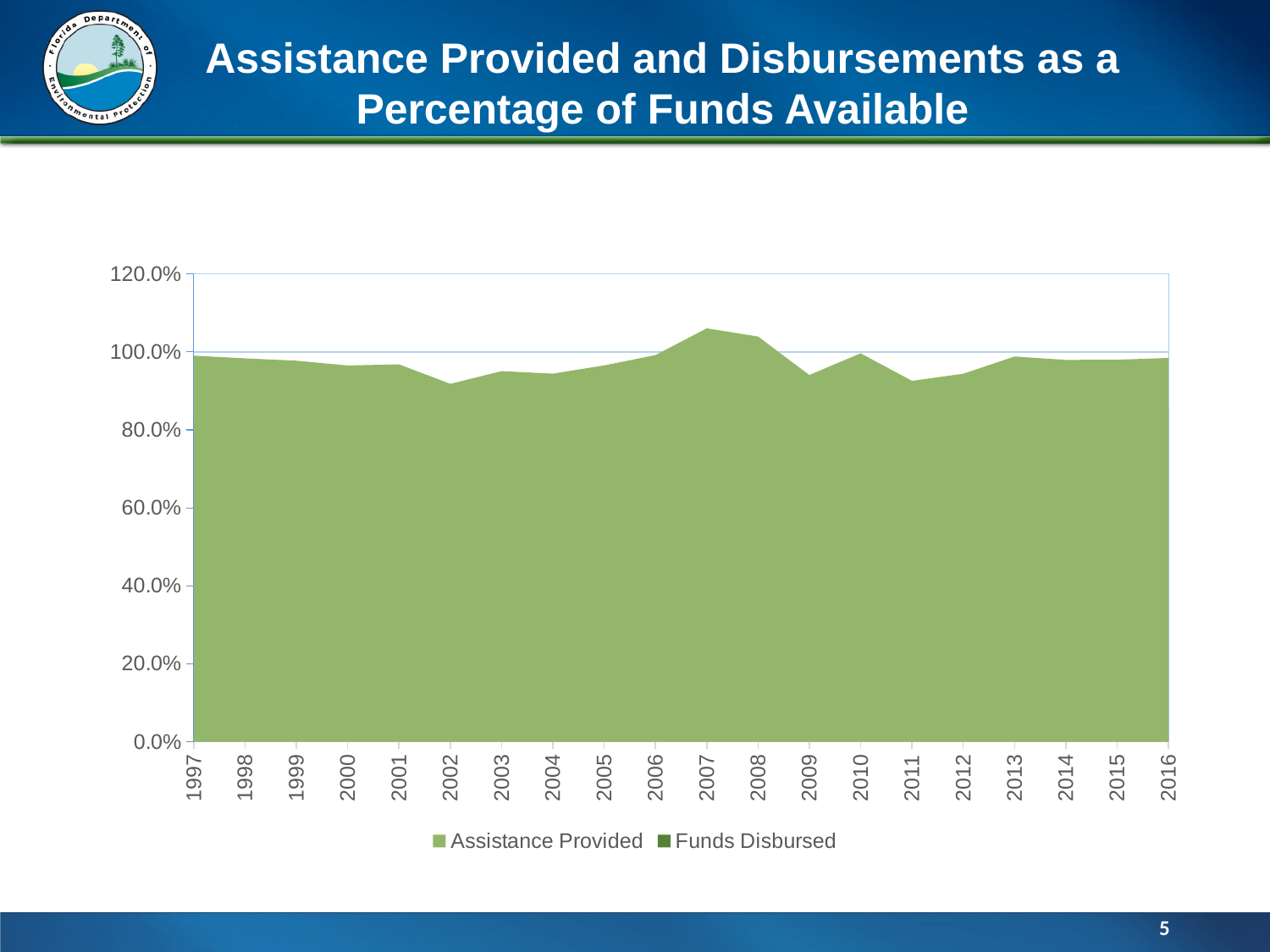
What kind of chart is shown on the slide? Area chart Which year has the highest value for Assistance Provided? 2007 Does the Assistance Provided value rise or fall from 2002 to 2007? rise Is the value for Assistance Provided in 2007 greater or less than 100.0%? greater Which is larger, the Assistance Provided value for 2007 or for 2009? 2007 Is the value for Assistance Provided in 2009 greater or less than 100.0%? less How many series does the legend list? 2 What is the title of the chart on the slide? Assistance Provided and Disbursements as a Percentage of Funds Available Is the value for Assistance Provided in 2008 greater or less than 100.0%? greater How many years are shown along the x axis? 20 Which is larger, the Assistance Provided value for 2002 or for 2013? 2013